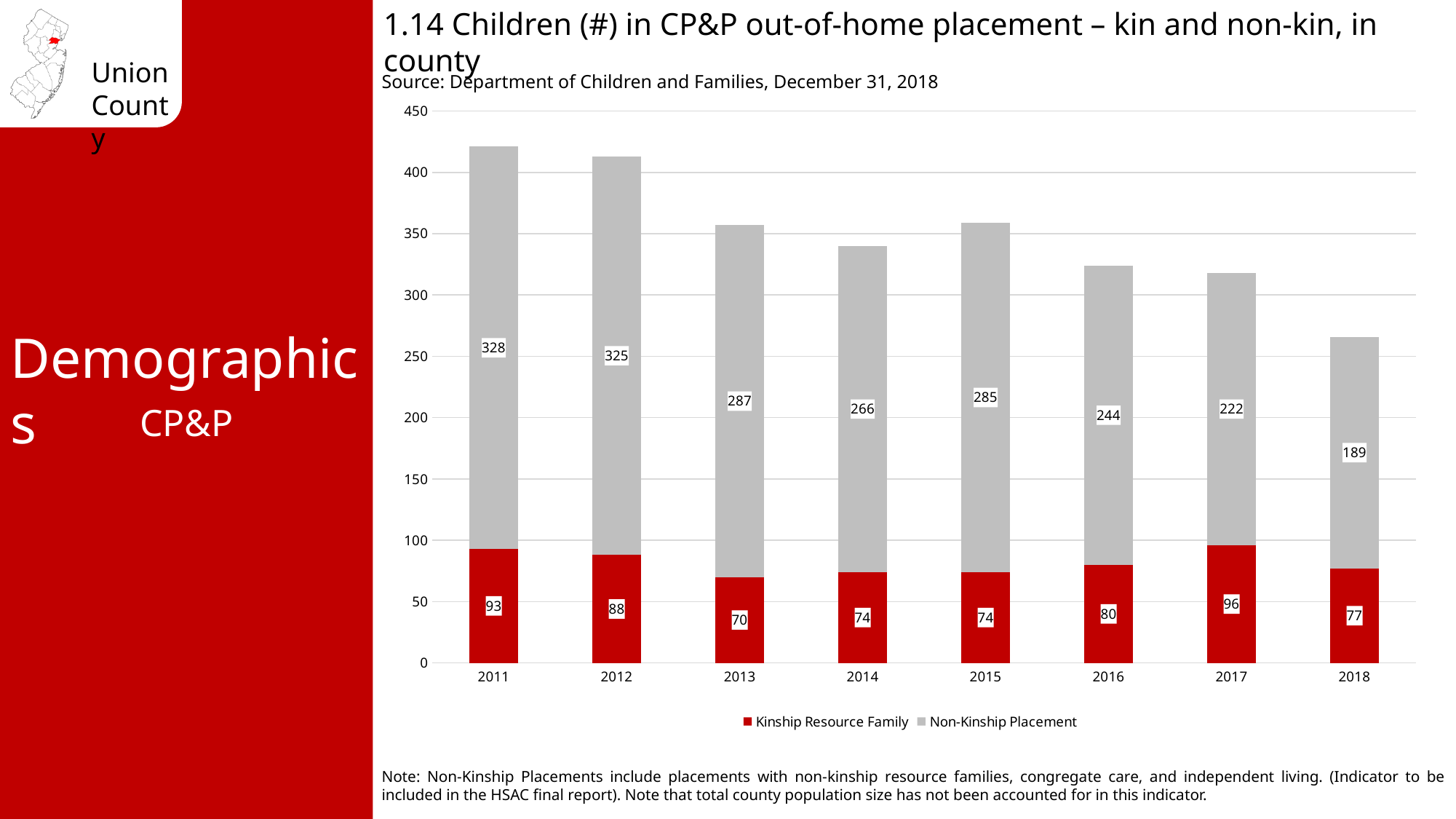
How many years are shown on the x axis? 8 What is the total of the stacked bar for 2018? 266 Is the total height of the 2014 stacked bar greater or less than 300? greater What is the difference between the Non-Kinship Placement values for 2011 and 2018? 139 What is the Non-Kinship Placement value for 2013? 287 Which is larger, the Kinship Resource Family value for 2016 or for 2018? 2016 How many series does the legend list? 2 Which year has the lowest Kinship Resource Family value? 2013 What is the Kinship Resource Family value for 2017? 96 Which year has the highest Non-Kinship Placement value? 2011 Which series is shown in red? Kinship Resource Family What kind of chart is shown on the slide? Stacked bar chart